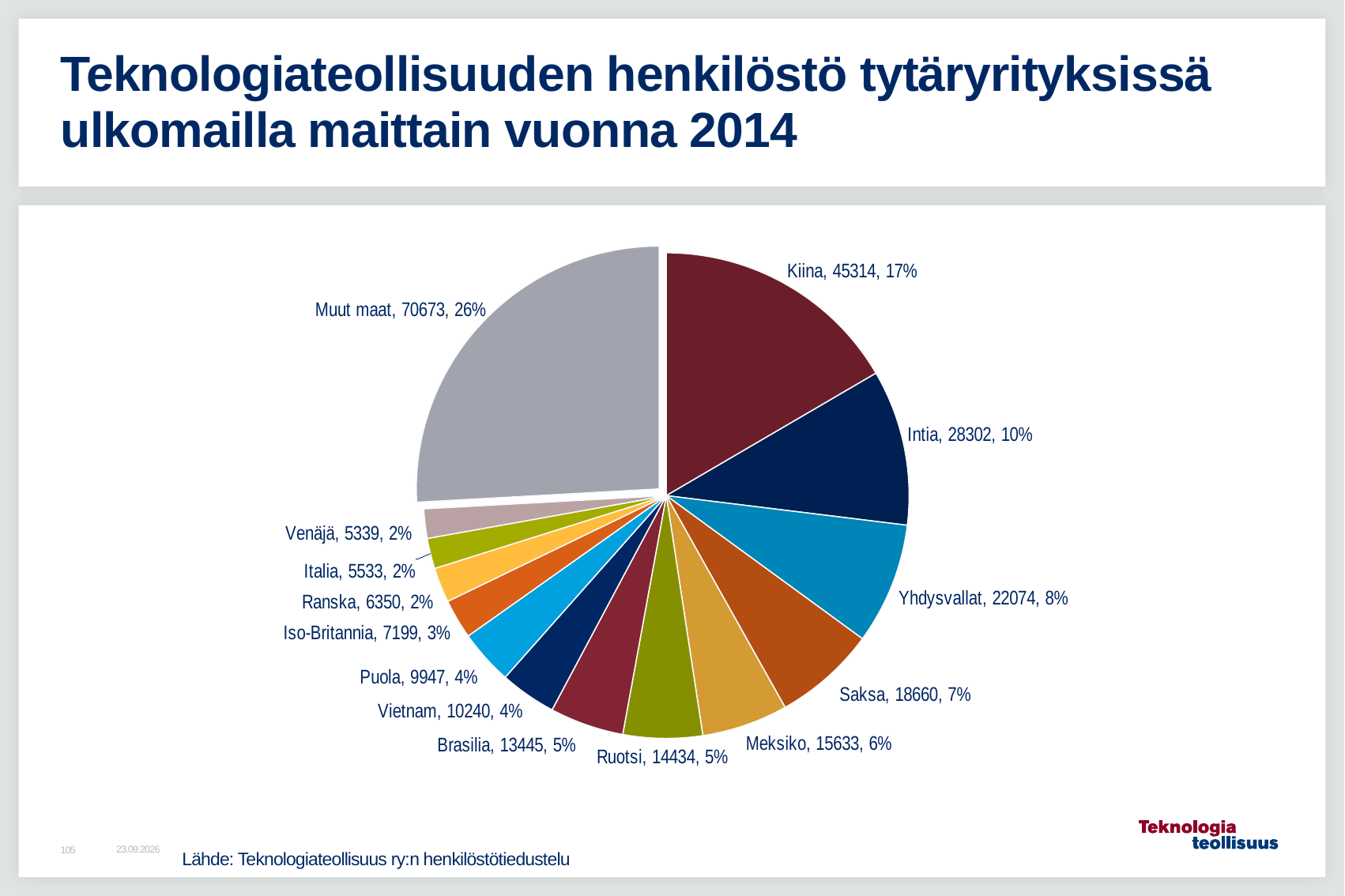
What is the value for Kiina? 45314 What is the value for Yhdysvallat? 22074 What share of the pie does Intia have? 10% How many slices does the pie chart have? 14 What share of the pie does Muut maat have? 26% Which named country has the largest slice? Kiina What is the difference between the values for Kiina and Intia? 17012 Which is larger, the value for Saksa or the value for Meksiko? Saksa What is the value for Vietnam? 10240 Which slice is the smallest? Venäjä What kind of chart is shown on the slide? Pie chart Which slice is the largest? Muut maat